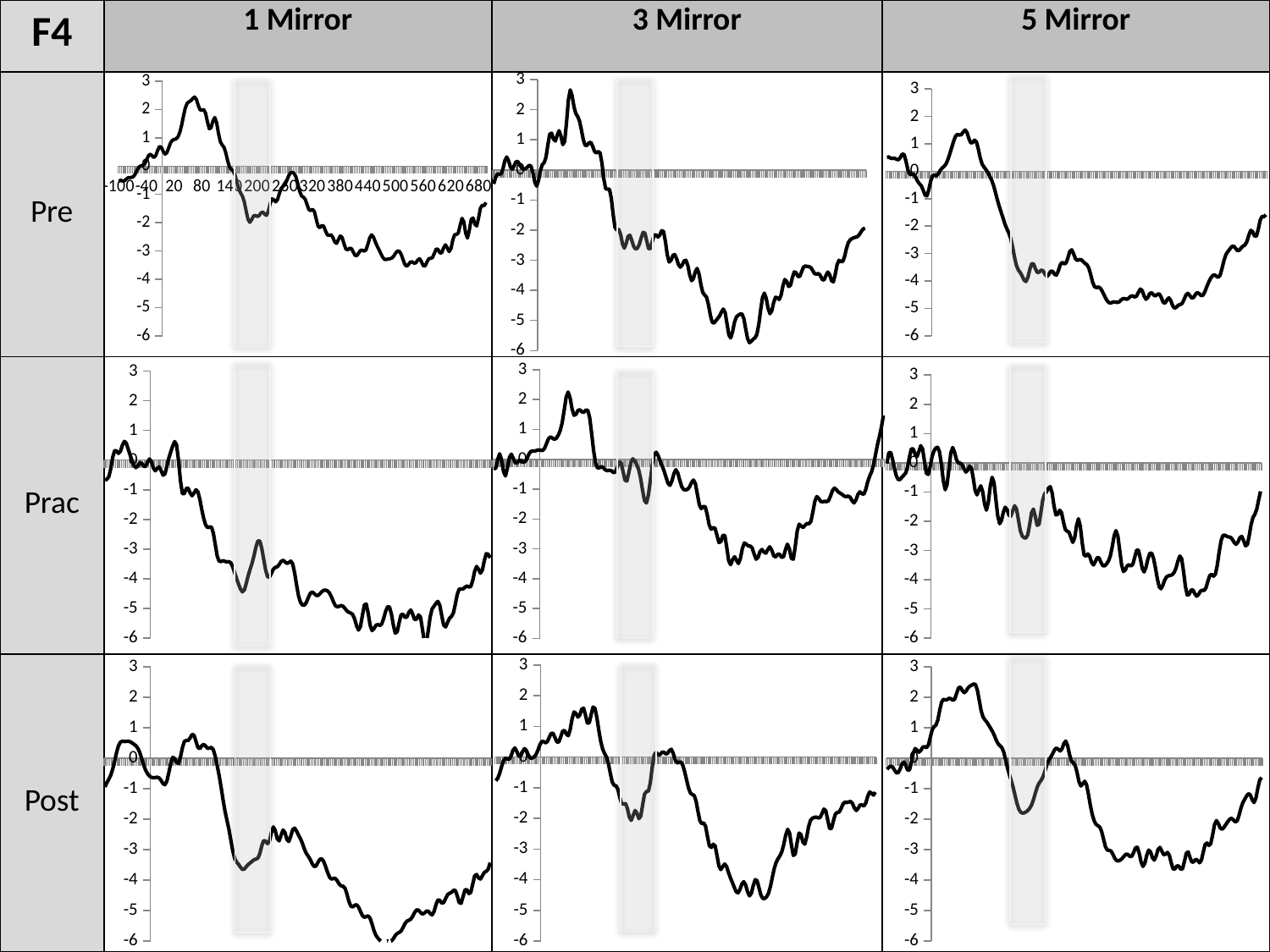
In the Pre / 3 Mirror chart, is the lowest point of the line greater or less than -5? less How many charts are arranged in the grid on the slide? 9 In the Prac / 3 Mirror chart, is the lowest point of the line greater or less than -4? greater In the Pre / 5 Mirror chart, is the peak of the line greater or less than 2? less What are the three column headings of the grid? 1 Mirror, 3 Mirror, 5 Mirror What kind of chart is shown in each panel of the grid? line chart In the Pre row, which chart has the higher peak: 1 Mirror or 5 Mirror? 1 Mirror In the Pre / 1 Mirror chart, what is the highest value shown on the y axis? 3 What label appears in the top-left cell of the grid? F4 In the Pre / 1 Mirror chart, what is the lowest value shown on the y axis? -6